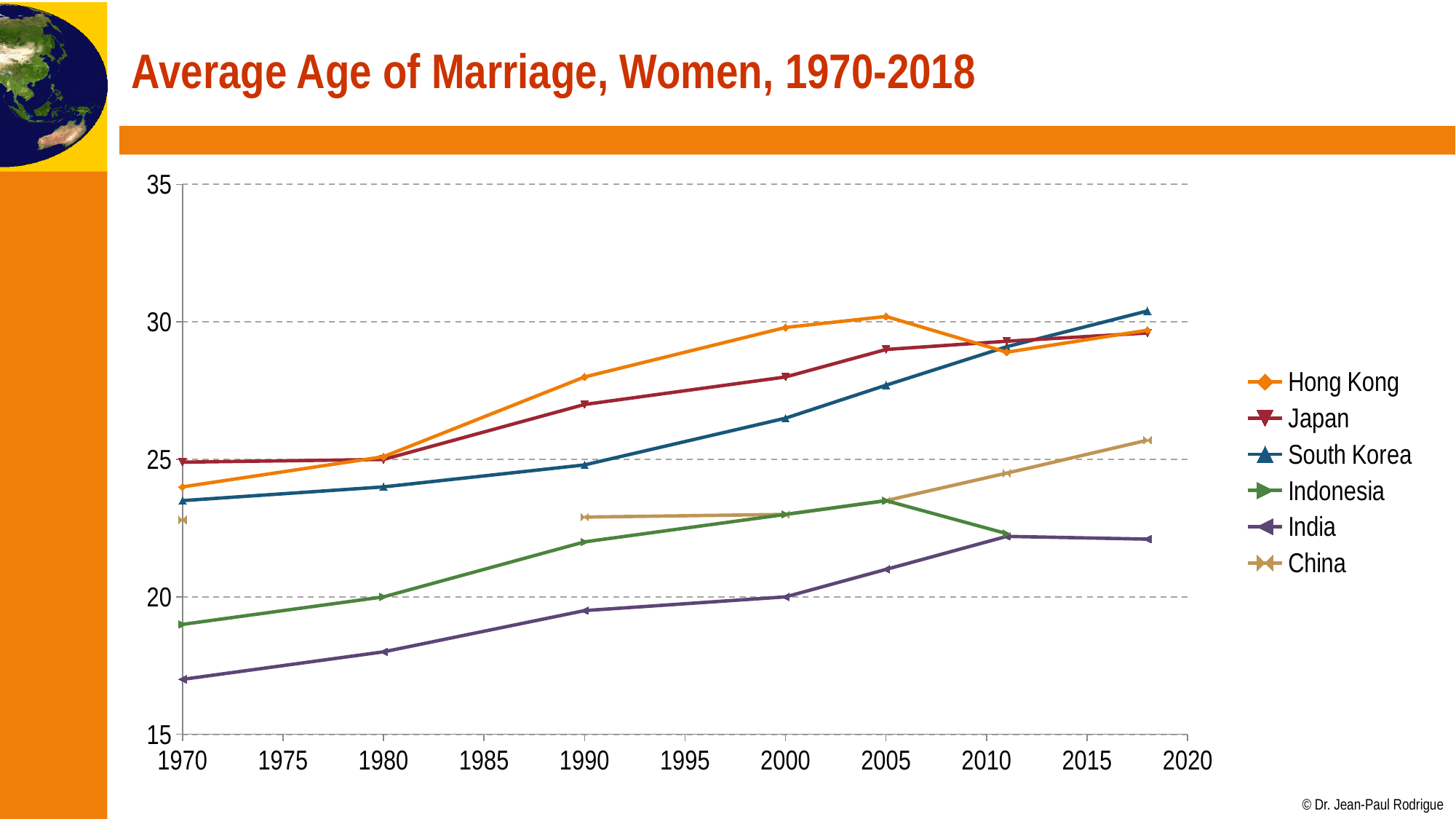
Does the South Korea line rise or fall from 1970 to 2018? rise How many series does the legend list? 6 Which country has the highest average age of marriage in 2018? South Korea What is the title of the chart? Average Age of Marriage, Women, 1970-2018 In 2005, which is higher, Hong Kong or Japan? Hong Kong Is the value for Hong Kong in 1970 greater or less than 25? less Is the value for India in 1970 greater or less than 20? less Which country has the lowest average age of marriage in 2018? India Is the value for South Korea in 2018 greater or less than 30? greater Which country has the lowest average age of marriage in 1970? India What kind of chart is shown on the slide? line chart